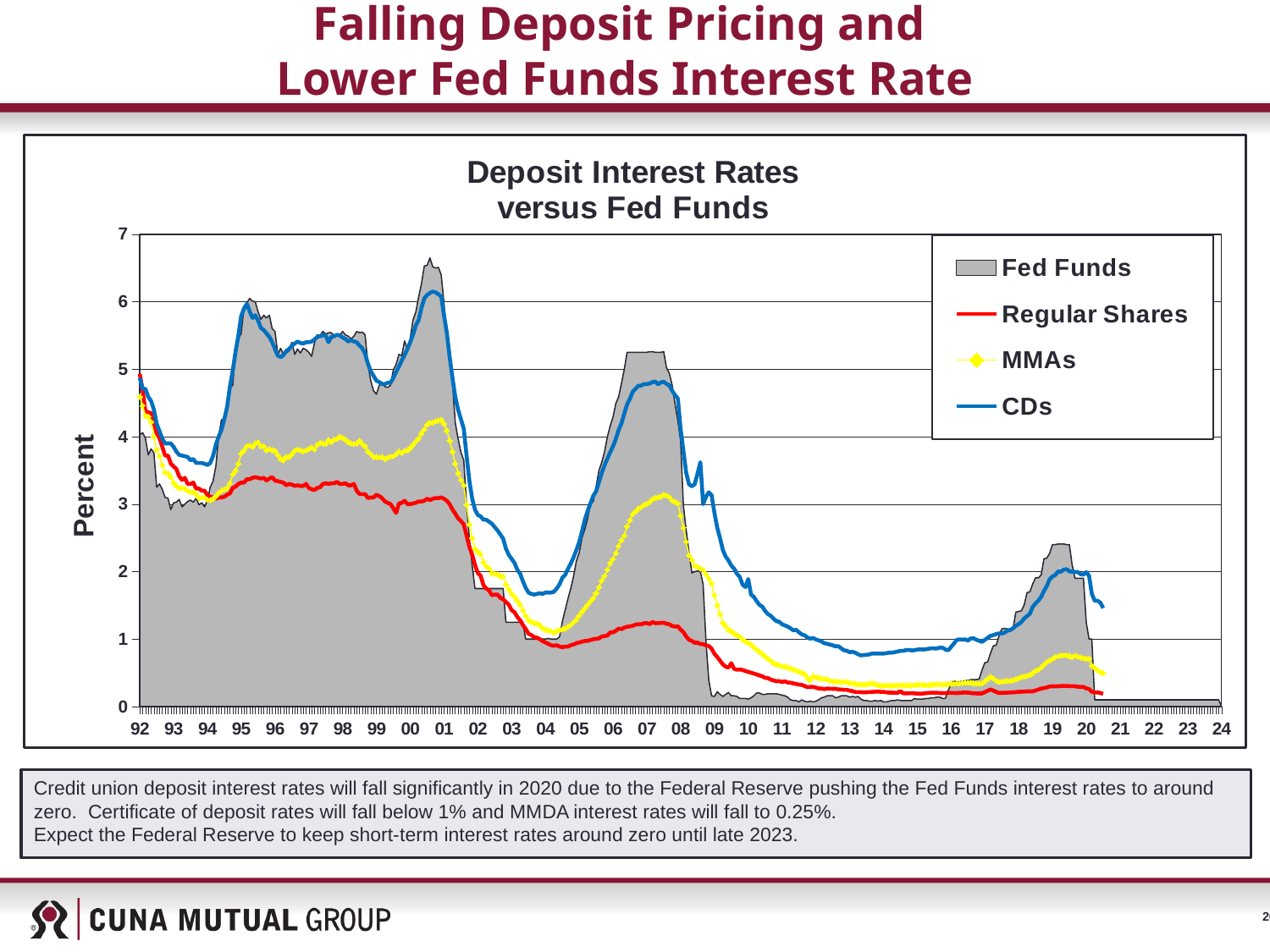
Which series has the highest value around 2007? Fed Funds What is the title of the chart? Deposit Interest Rates versus Fed Funds Is the MMAs value around 2007 greater or less than 2? greater Is the Fed Funds value at its peak around 2000-01 greater or less than 6? greater Is the Fed Funds value around 2007 greater or less than 5? greater How many series does the chart's legend list? 4 Around 2007, which is larger: the CDs value or the Regular Shares value? CDs Does the Fed Funds value rise or fall between 2007 and 2009? fall What is the label on the vertical axis of the chart? Percent